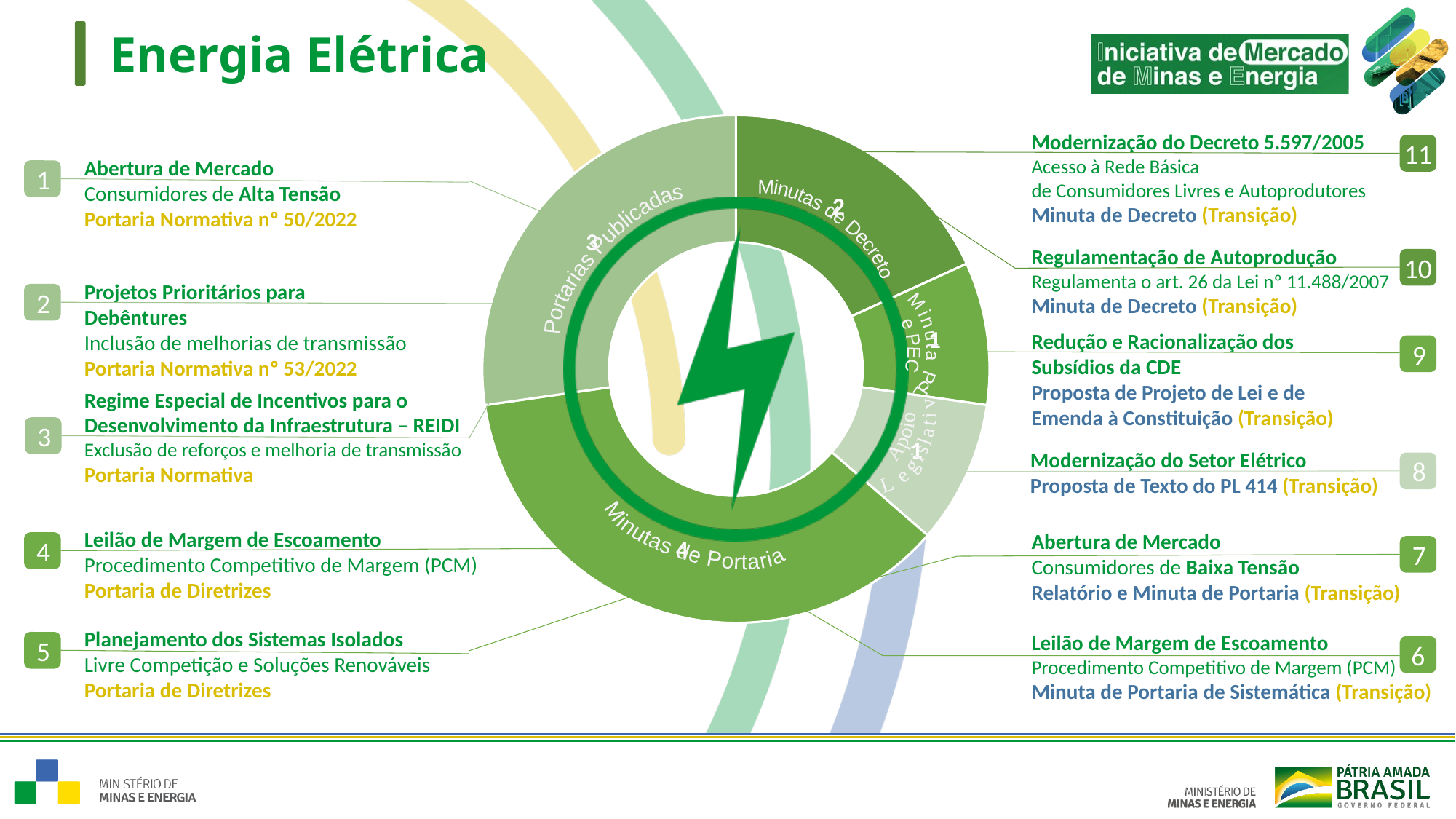
Which is larger, the 'Minutas de Portaria' segment or the 'Minutas de Decreto' segment? Minutas de Portaria How many segments does the donut chart have? 5 What value is shown on the 'Apoio Legislativo' segment? 1 What is the difference between the 'Minutas de Portaria' value and the 'Portarias Publicadas' value? 1 Which segment of the donut chart has the highest value? Minutas de Portaria What kind of chart is shown in the centre of the slide? Donut (pie) chart What icon is shown in the centre of the donut chart? A green lightning bolt What is the title of the slide containing the donut chart? Energia Elétrica What value is shown on the 'Portarias Publicadas' segment? 3 What value is shown on the 'Minutas de Decreto' segment? 2 What value is shown on the 'Minutas de Portaria' segment? 4 What is the total of all segment values in the donut chart? 11